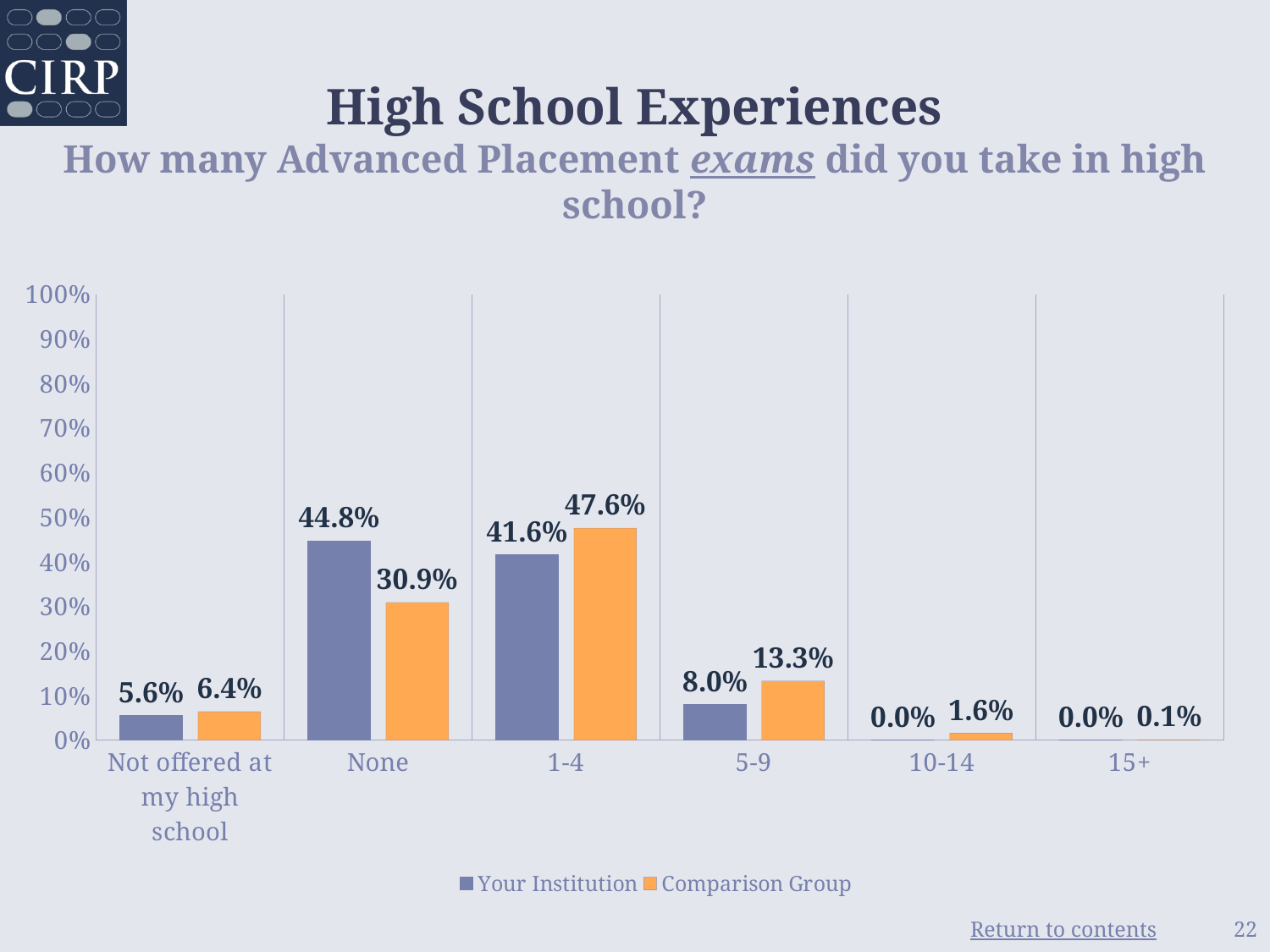
Which category has the highest value for Your Institution? None What is the Comparison Group value for the 'None' category? 30.9% What kind of chart is shown on the slide? Bar chart How many series does the legend list? 2 For 5-9 exams, which series has the larger value, Your Institution or the Comparison Group? Comparison Group Which category has the highest value for the Comparison Group? 1-4 What is the difference between Your Institution and the Comparison Group for the 'None' category? 13.9% What percentage of Your Institution respondents took 1-4 Advanced Placement exams? 41.6% Which category has the lowest value for the Comparison Group? 15+ What is the Comparison Group value for 5-9 exams? 13.3% How many categories are shown on the x axis? 6 What is the difference between the Comparison Group and Your Institution for 1-4 exams? 6.0%